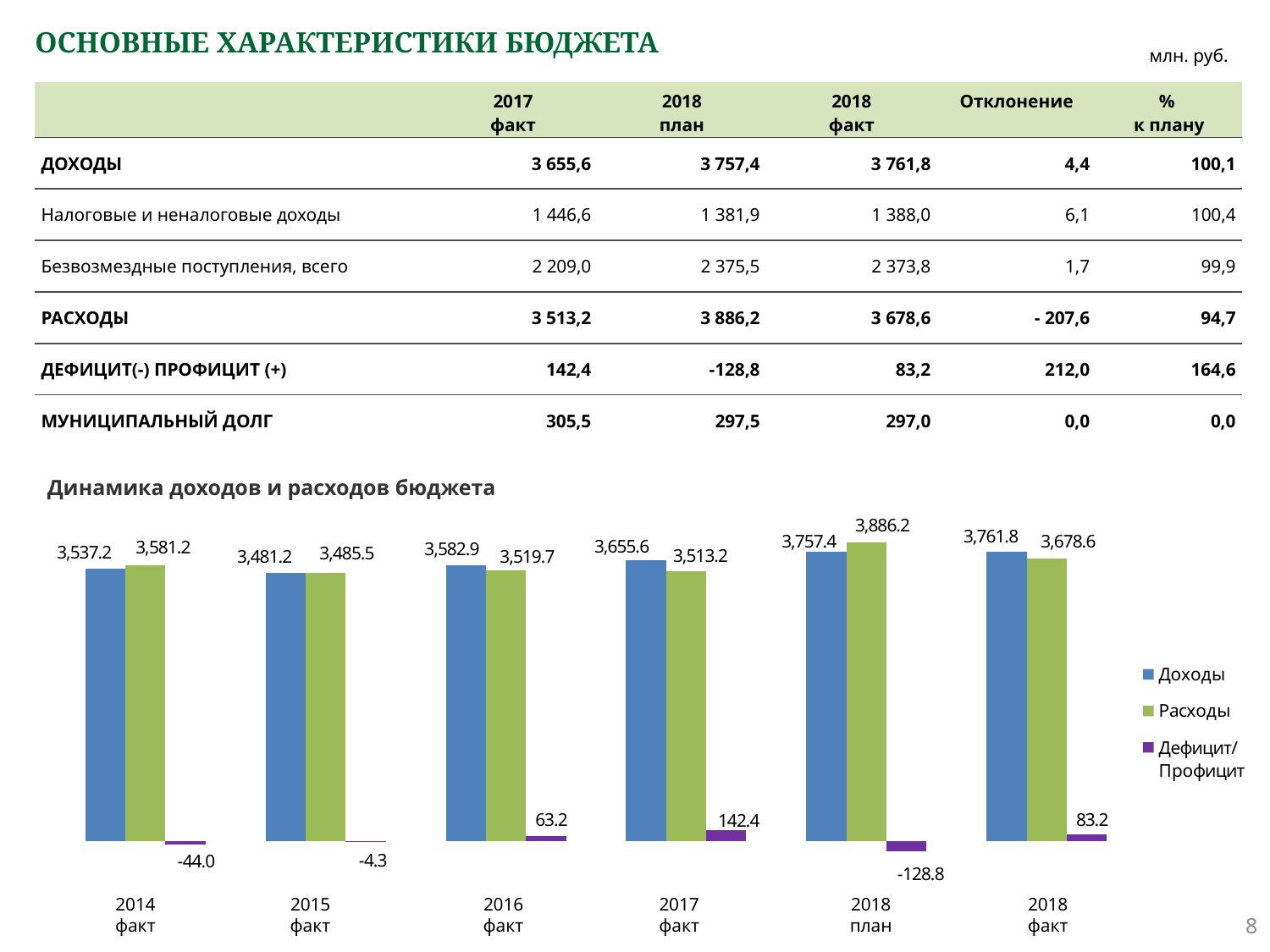
What is the difference between Расходы and Доходы for 2018 план in the chart? 128.8 What is the value of Расходы for 2018 план in the chart? 3,886.2 In the chart, is Доходы or Расходы larger for 2017 факт? Доходы What is the value of Доходы for 2017 факт in the chart? 3,655.6 What kind of chart is shown on the slide? Bar chart What is the title of the chart on the slide? Динамика доходов и расходов бюджета How many categories are shown on the x axis of the chart? 6 Which category has the lowest Дефицит/Профицит value in the chart? 2018 план Which category has the lowest Доходы value in the chart? 2015 факт How many series does the chart legend list? 3 What is the Дефицит/Профицит value for 2016 факт in the chart? 63.2 Which category has the highest Расходы value in the chart? 2018 план